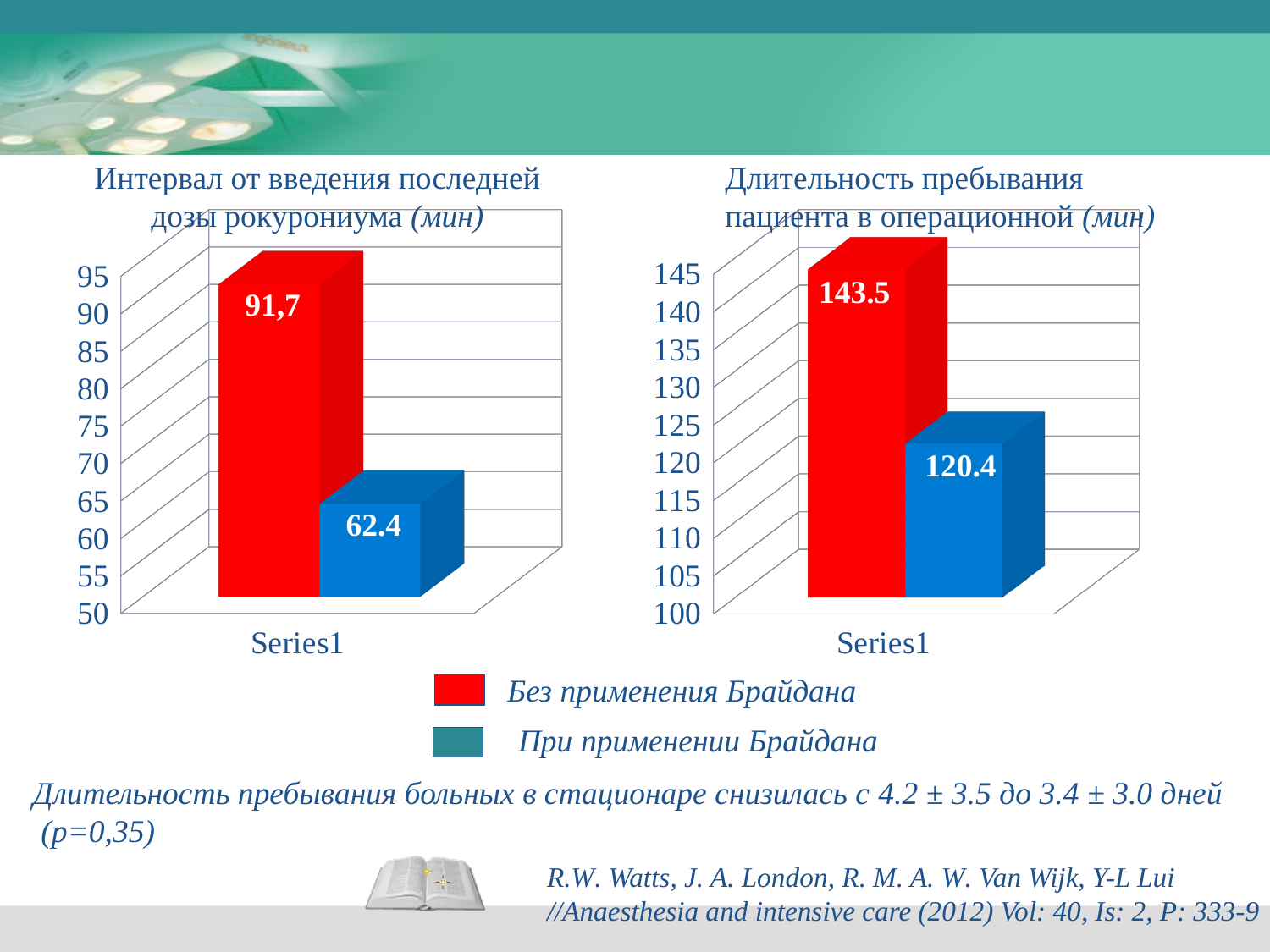
In the left chart (Интервал от введения последней дозы рокурониума), what is the value for 'Без применения Брайдана'? 91,7 What kind of chart is the left chart (Интервал от введения последней дозы рокурониума)? Bar chart In the left chart (Интервал от введения последней дозы рокурониума), what is the value for 'При применении Брайдана'? 62.4 How many bars are plotted in the right chart (Длительность пребывания пациента в операционной)? 2 How many entries does the shared legend below the charts list? 2 In the right chart (Длительность пребывания пациента в операционной), what is the value for 'При применении Брайдана'? 120.4 In the left chart (Интервал от введения последней дозы рокурониума), is the value for 'При применении Брайдана' greater or less than 65? less In the right chart (Длительность пребывания пациента в операционной), what is the value for 'Без применения Брайдана'? 143.5 In the right chart (Длительность пребывания пациента в операционной), is the value for 'Без применения Брайдана' greater or less than 140? greater In the right chart (Длительность пребывания пациента в операционной), what is the difference between the 'Без применения Брайдана' and 'При применении Брайдана' values? 23.1 In the right chart (Длительность пребывания пациента в операционной), which bar is the lowest? При применении Брайдана In the left chart (Интервал от введения последней дозы рокурониума), which bar is higher: 'Без применения Брайдана' or 'При применении Брайдана'? Без применения Брайдана